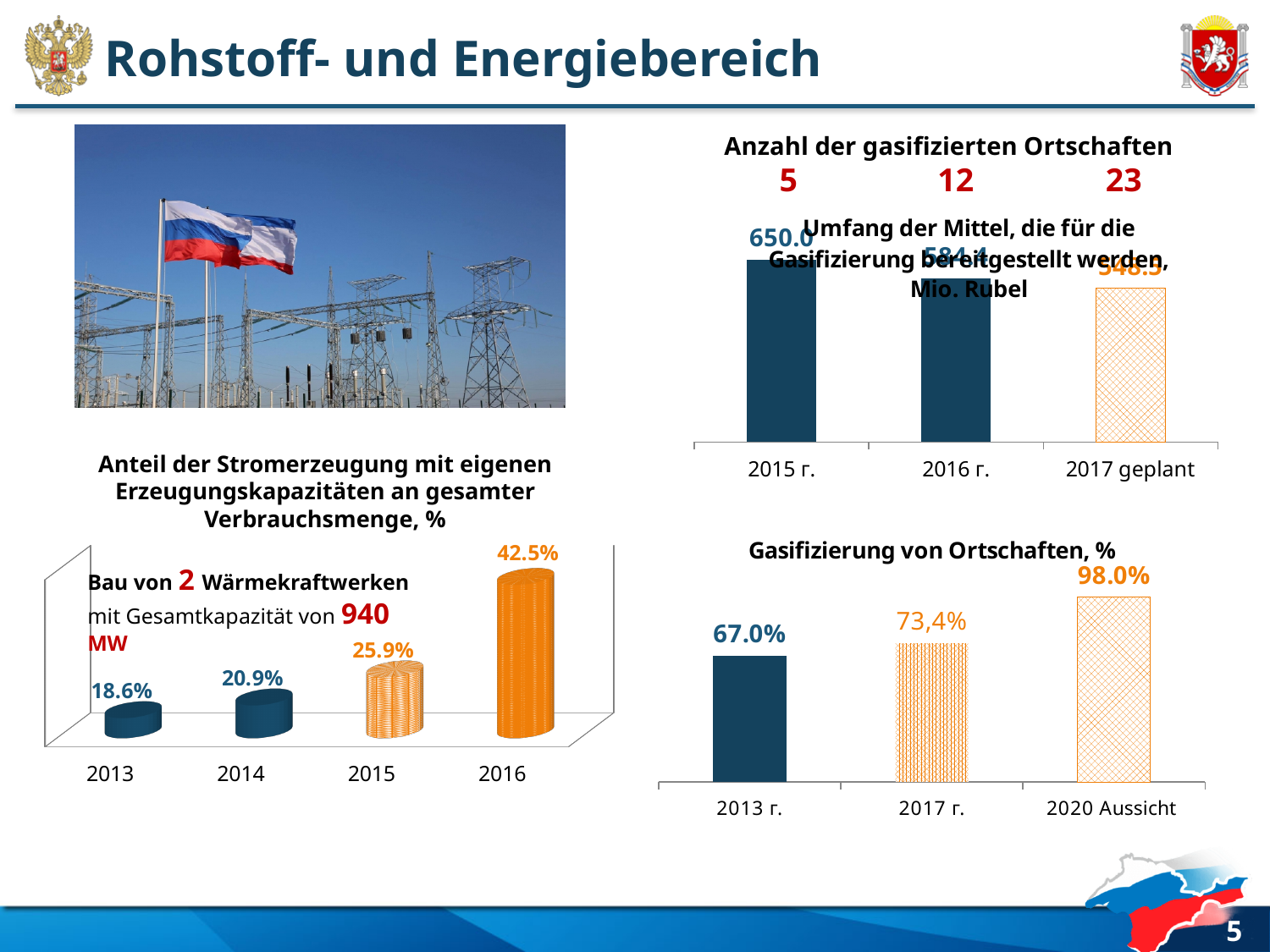
How many years are shown in the chart 'Anteil der Stromerzeugung mit eigenen Erzeugungskapazitäten an gesamter Verbrauchsmenge, %'? 4 In the chart 'Anteil der Stromerzeugung mit eigenen Erzeugungskapazitäten an gesamter Verbrauchsmenge, %', which year has the lowest value? 2013 In the chart 'Anteil der Stromerzeugung mit eigenen Erzeugungskapazitäten an gesamter Verbrauchsmenge, %', what is the difference between the 2016 and 2015 values? 16.6% In the chart 'Umfang der Mittel, die für die Gasifizierung bereitgestellt werden, Mio. Rubel', which category has the lowest value? 2017 geplant In the chart 'Anteil der Stromerzeugung mit eigenen Erzeugungskapazitäten an gesamter Verbrauchsmenge, %', do the values rise or fall from 2013 to 2016? rise What kind of chart is 'Gasifizierung von Ortschaften, %'? bar chart In the chart 'Umfang der Mittel, die für die Gasifizierung bereitgestellt werden, Mio. Rubel', what is the value for 2015 г.? 650.0 In the chart 'Anteil der Stromerzeugung mit eigenen Erzeugungskapazitäten an gesamter Verbrauchsmenge, %', what is the value for 2013? 18.6% In the chart 'Gasifizierung von Ortschaften, %', what is the difference between the 2020 Aussicht and 2013 г. values? 31.0% In the chart 'Umfang der Mittel, die für die Gasifizierung bereitgestellt werden, Mio. Rubel', which category has the highest value? 2015 г. In the chart 'Gasifizierung von Ortschaften, %', what is the value for 2020 Aussicht? 98.0% In the chart 'Anteil der Stromerzeugung mit eigenen Erzeugungskapazitäten an gesamter Verbrauchsmenge, %', what is the value for 2016? 42.5%